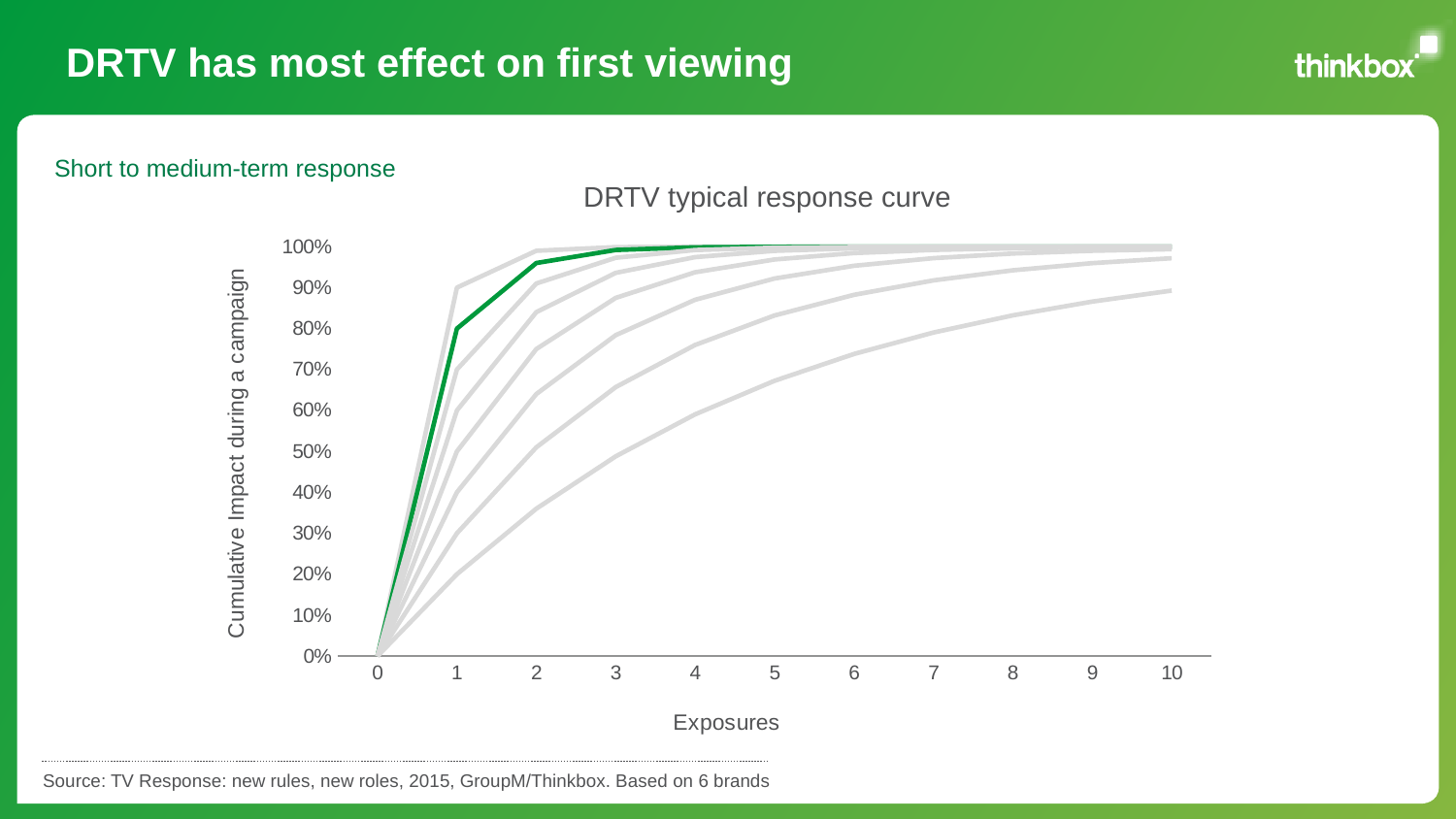
What is the label of the x axis? Exposures Is the value of the lowest grey curve at 10 exposures greater or less than 80%? greater Is the value of the lowest grey curve at 1 exposure greater or less than 30%? less At 1 exposure, which is larger: the value of the green curve or the value of the lowest grey curve? the green curve Is the value of the green curve at 1 exposure greater or less than 70%? greater Do the curves rise or fall as the number of exposures increases? rise What kind of chart is shown on the slide? line chart What is the title of the chart? DRTV typical response curve What is the cumulative impact value of the curves at 0 exposures? 0% How many exposure values are marked on the x axis? 11